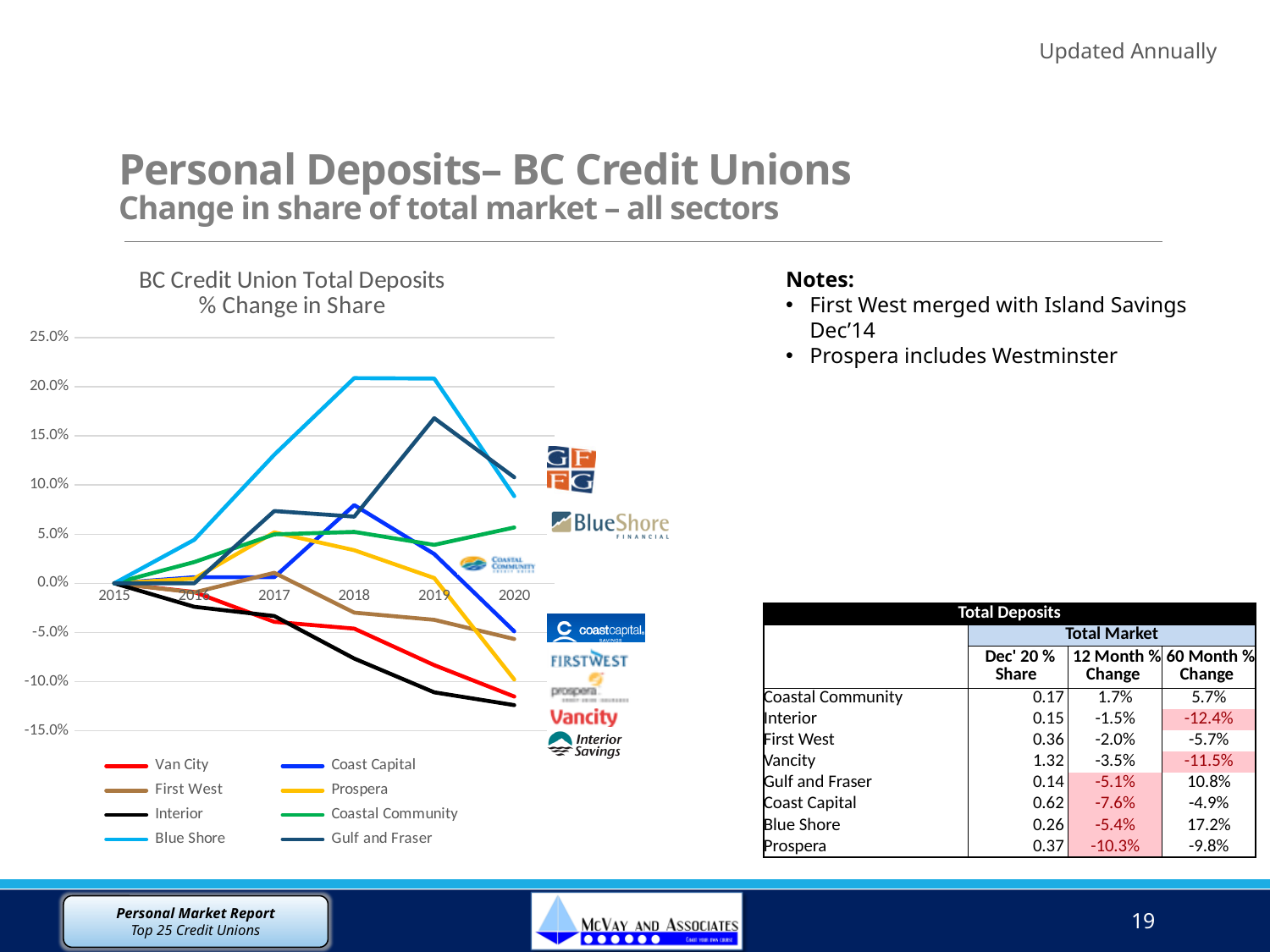
Is the value for Gulf and Fraser in 2019 greater or less than 15.0%? greater Is the value for Blue Shore in 2018 greater or less than 15.0%? greater Does the Interior line rise or fall from 2015 to 2020? fall What is the title of the chart? BC Credit Union Total Deposits % Change in Share In 2018, which is higher: Blue Shore or Gulf and Fraser? Blue Shore How many series does the chart legend list? 8 How many years are shown along the x axis of the chart? 6 Which series reaches the highest point anywhere on the chart? Blue Shore What kind of chart is shown on the slide? line chart Which series is drawn in red in the chart? Van City Which series has the highest value in 2020? Gulf and Fraser Is the value for Interior in 2020 greater or less than -10.0%? less